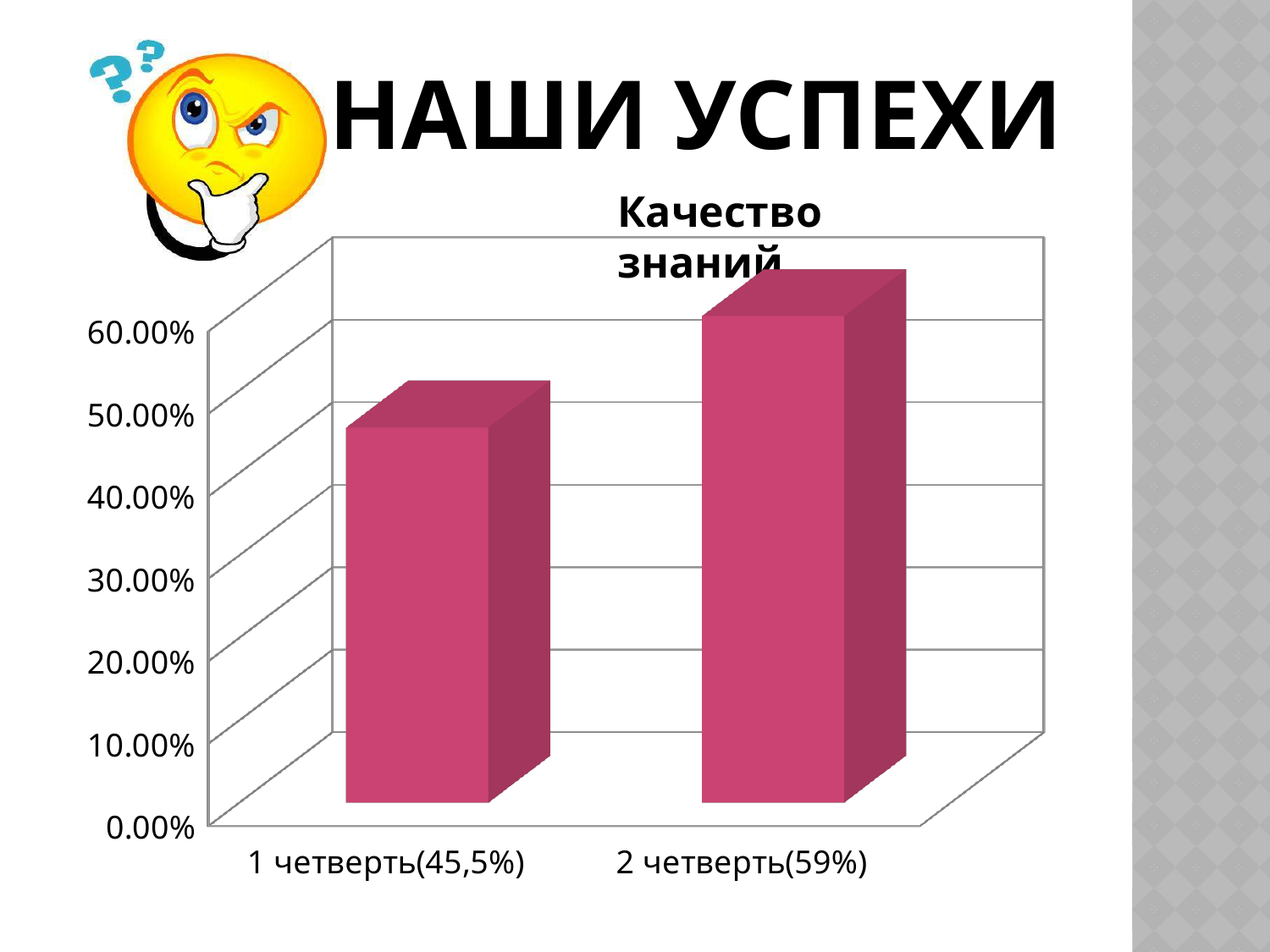
Do the values rise or fall from 1 четверть to 2 четверть? rise What kind of chart is shown on the slide? bar chart What is the difference between the values for 2 четверть and 1 четверть? 13,5% Which category has the lowest value? 1 четверть(45,5%) Which is larger, the value for 1 четверть or for 2 четверть? 2 четверть How many categories (bars) does the chart show? 2 Which category has the highest value? 2 четверть(59%) What value is given for 2 четверть in its category label? 59% What is the title of the chart? Качество знаний What value is given for 1 четверть in its category label? 45,5% Is the value for 2 четверть greater or less than 50.00%? greater Is the value for 1 четверть greater or less than 50.00%? less